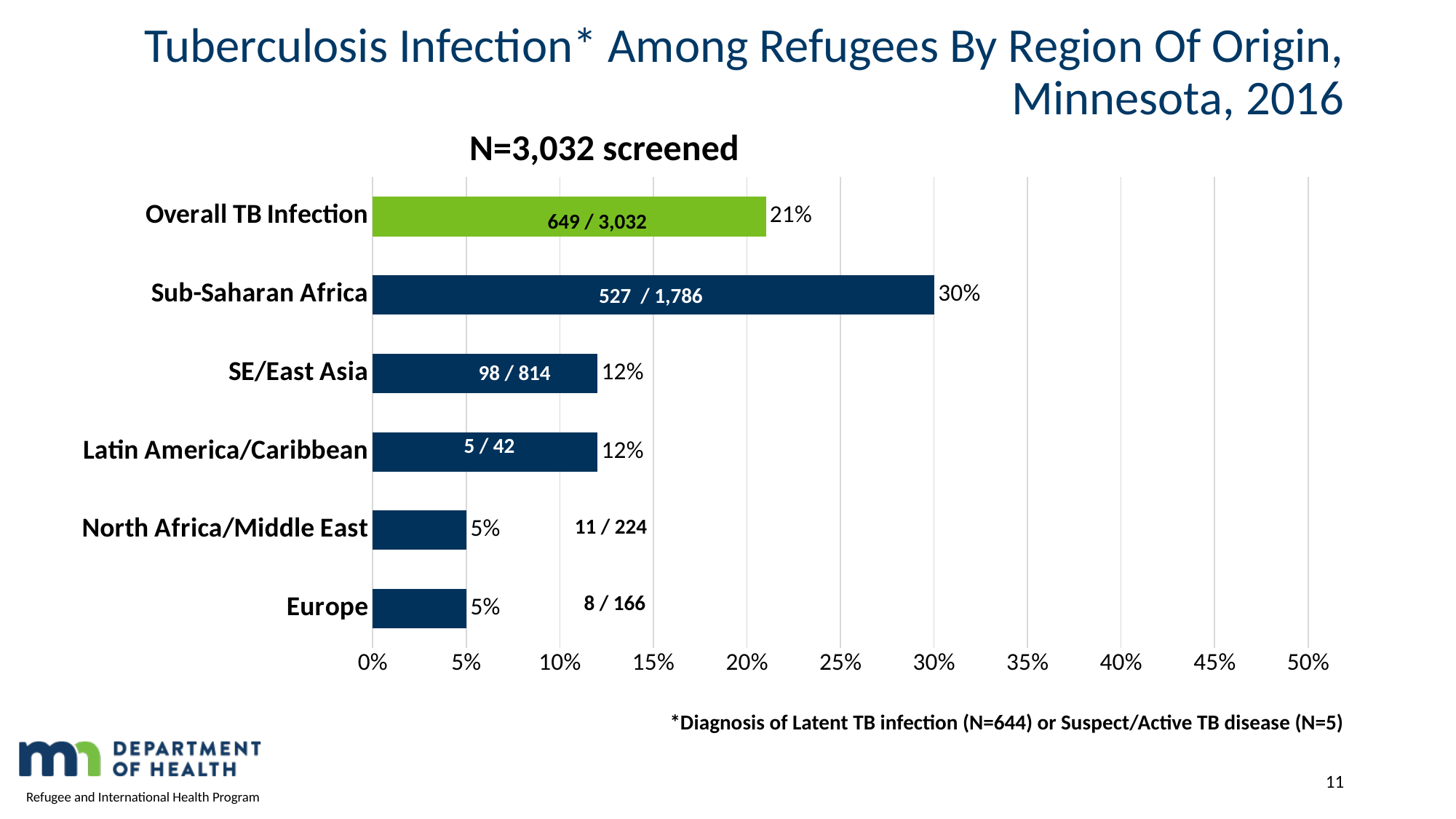
What is the TB infection percentage for Europe? 5% What is the difference in percentage points between Sub-Saharan Africa and SE/East Asia? 18% What is the Overall TB Infection percentage shown on the chart? 21% How many bars are shown on the chart? 6 What is the total number screened stated above the chart? N=3,032 screened Which region of origin has the highest TB infection percentage? Sub-Saharan Africa What fraction is printed on the bar for SE/East Asia? 98 / 814 Is the value for Latin America/Caribbean greater or less than 10%? greater What kind of chart is shown on the slide? Bar chart What is the TB infection percentage for Sub-Saharan Africa? 30% Which has a higher TB infection percentage, Sub-Saharan Africa or Overall TB Infection? Sub-Saharan Africa What fraction is printed next to the North Africa/Middle East bar? 11 / 224